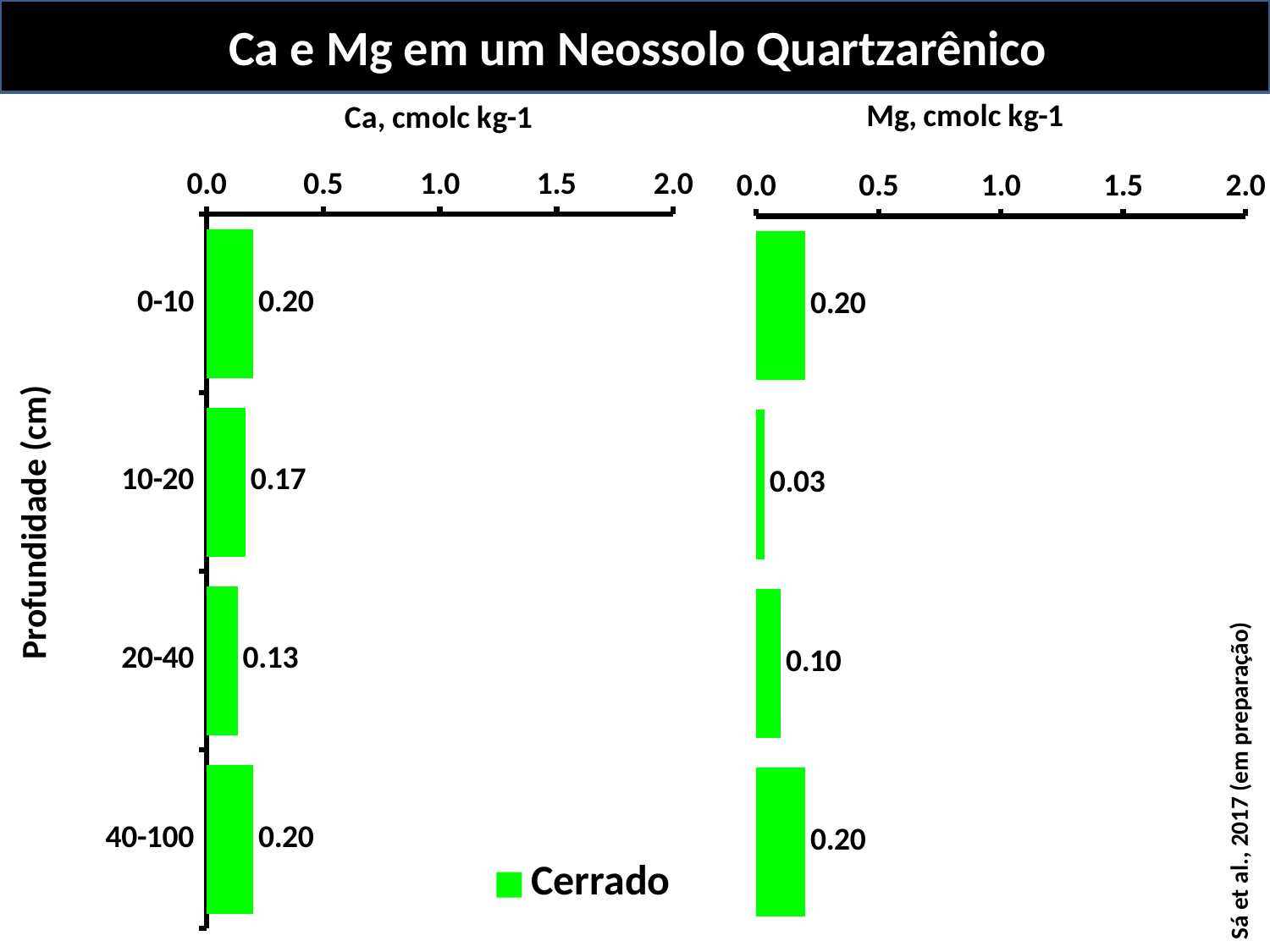
What type of chart is used for the Mg chart (right)? Bar chart In the Ca chart (left), which depth has the lowest Ca value? 20-40 In the Mg chart (right), what is the difference between the 0-10 cm and 10-20 cm values? 0.17 In the Mg chart (right), which depth has the lowest Mg value? 10-20 In the Ca chart (left), what is the difference between the 10-20 cm and 20-40 cm values? 0.04 How many depth categories are shown in the Ca chart (left)? 4 Which is larger: the Ca value at 10-20 cm or the Mg value at 10-20 cm? Ca value at 10-20 cm In the Ca chart (left), what is the value for the 20-40 cm depth? 0.13 In the Ca chart (left), what is the value for the 10-20 cm depth? 0.17 In the Mg chart (right), what is the value for the 20-40 cm depth? 0.10 In the Mg chart (right), what is the value for the 10-20 cm depth? 0.03 What is the single series named in the legend? Cerrado